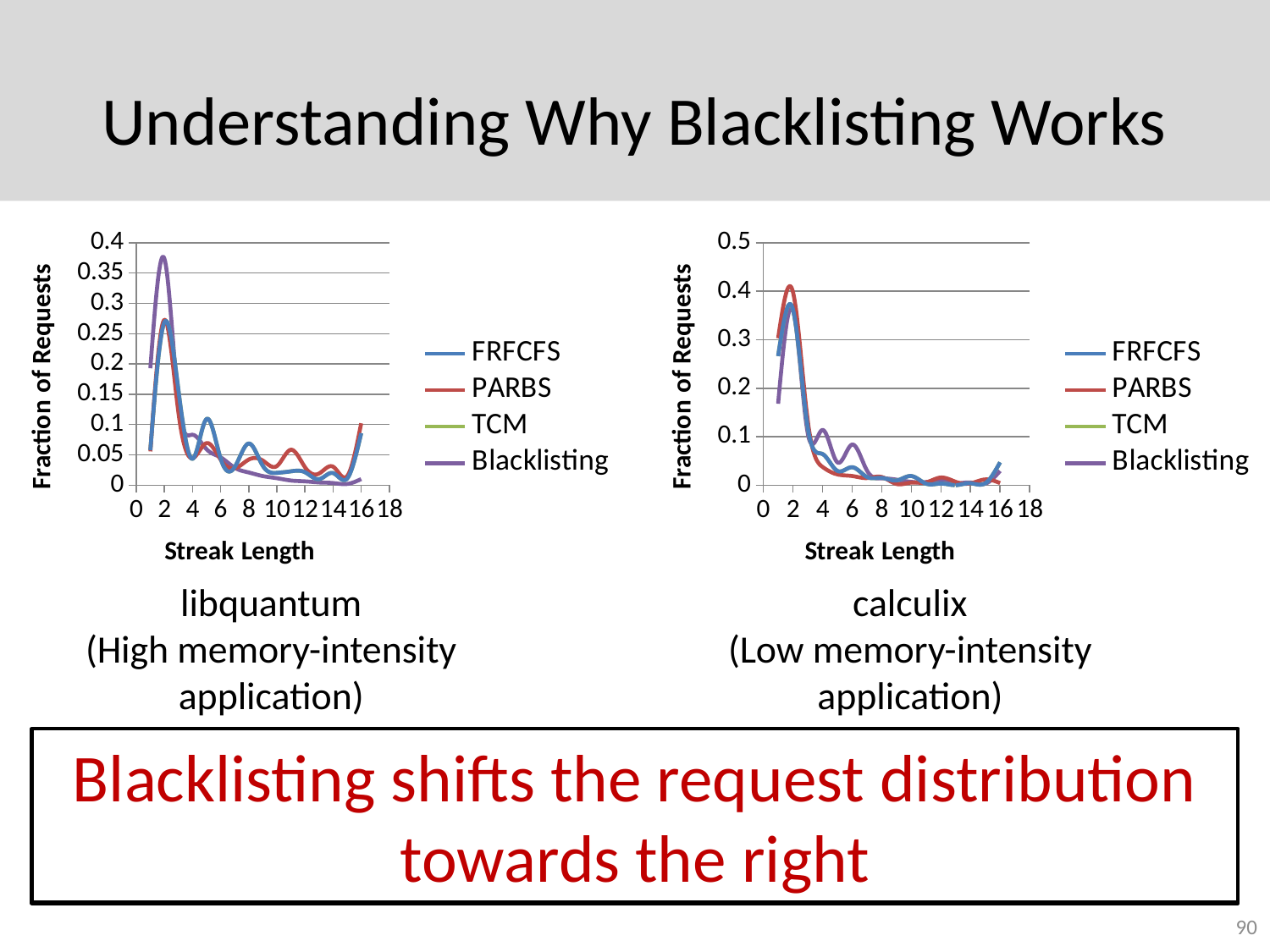
What kind of chart is the calculix chart on the right? line chart What is the x-axis title of the calculix chart? Streak Length How many series does the legend of the libquantum chart list? 4 In the libquantum chart, which series reaches the highest peak value? Blacklisting In the libquantum chart, is the peak value of the FRFCFS series greater or less than 0.3? less How many series does the legend of the calculix chart list? 4 What kind of chart is the libquantum chart on the left? line chart What is the y-axis title of the libquantum chart? Fraction of Requests In the calculix chart, do the values generally rise or fall as streak length increases beyond 2? fall In the calculix chart, is the value of the Blacklisting series at streak length 10 greater or less than 0.1? less In the libquantum chart, is the peak value of the Blacklisting series greater or less than 0.3? greater